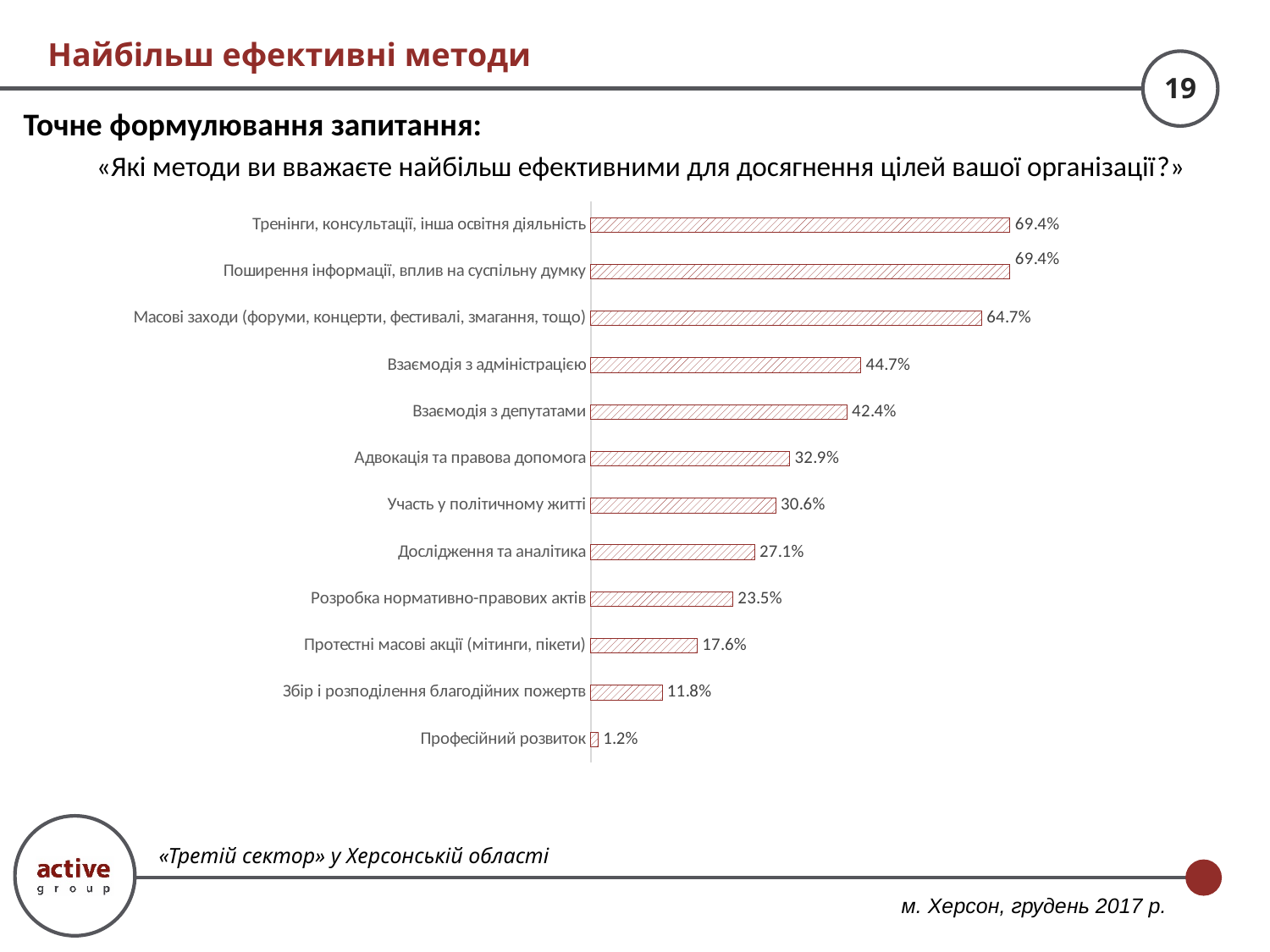
What is the value for «Протестні масові акції (мітинги, пікети)»? 17.6% What is the difference between «Взаємодія з адміністрацією» and «Взаємодія з депутатами»? 2.3% What kind of chart is shown on the slide? Bar chart What is the difference between «Адвокація та правова допомога» and «Збір і розподілення благодійних пожертв»? 21.1% How many categories are shown on the chart? 12 Which is larger: «Участь у політичному житті» or «Розробка нормативно-правових актів»? Участь у політичному житті What is the value for «Масові заходи (форуми, концерти, фестивалі, змагання, тощо)»? 64.7% What is the value for «Взаємодія з адміністрацією»? 44.7% What is the highest value shown on the chart? 69.4% Do the values increase or decrease going from the top category to the bottom category? Decrease What is the value for «Дослідження та аналітика»? 27.1% Which category has the lowest value? Професійний розвиток